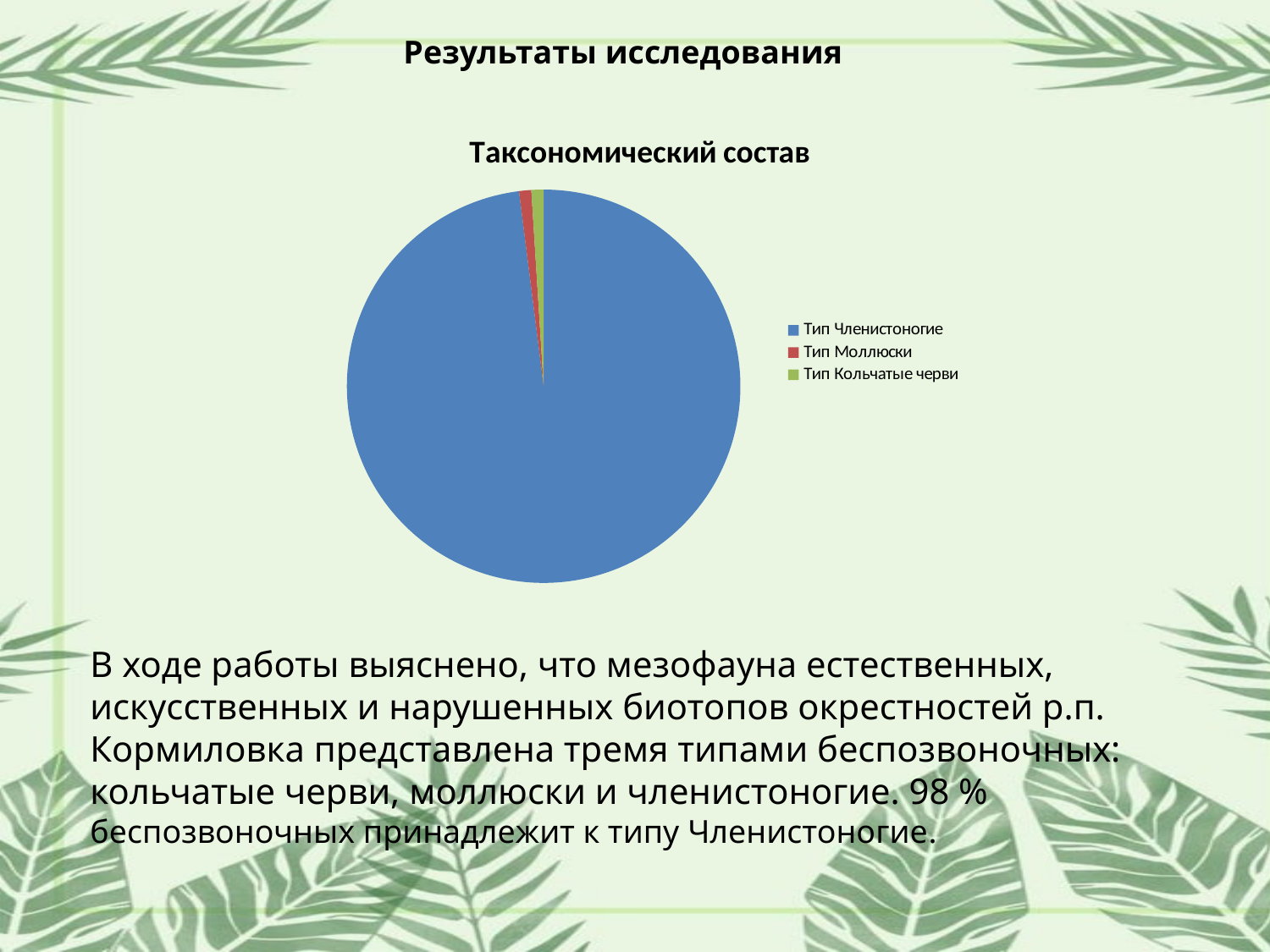
Which is larger, the slice for Тип Членистоногие or the slice for Тип Моллюски? Тип Членистоногие Which category has the largest slice of the pie? Тип Членистоногие Which is larger, the slice for Тип Кольчатые черви or the slice for Тип Членистоногие? Тип Членистоногие How many slices does the pie chart have? 3 What colour is the slice for Тип Членистоногие? blue What is the title of the chart? Таксономический состав What kind of chart is shown on the slide? pie chart How many entries does the chart legend list? 3